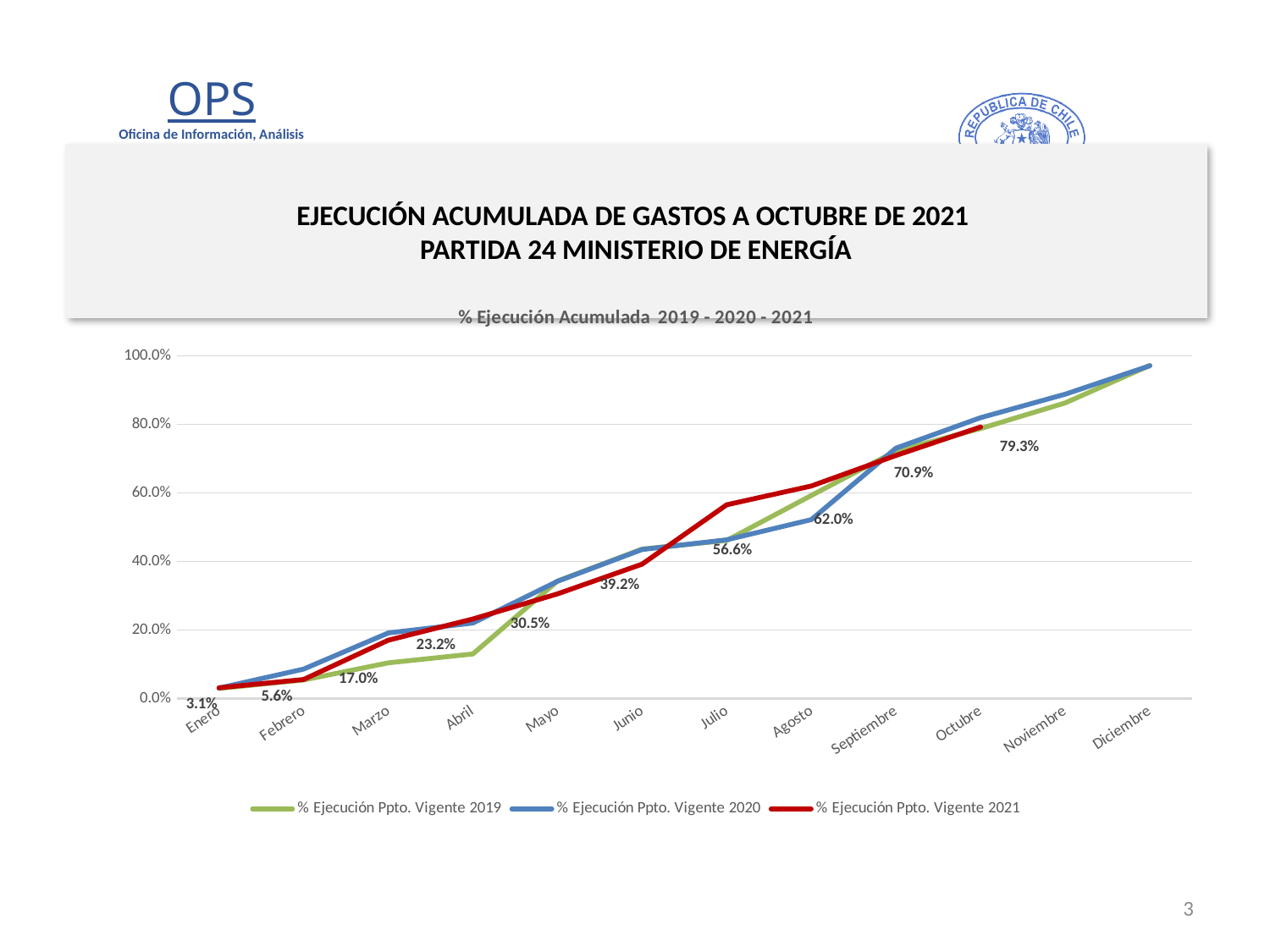
How many months are shown along the x axis? 12 What is the value for % Ejecución Ppto. Vigente 2021 in Enero? 3.1% What is the value for % Ejecución Ppto. Vigente 2021 in Julio? 56.6% How many series does the legend list? 3 Is the value for % Ejecución Ppto. Vigente 2020 in Diciembre greater or less than 80.0%? greater What is the difference between the 2021 values for Julio and Junio? 17.4% What is the title of the chart? % Ejecución Acumulada 2019 - 2020 - 2021 What is the value for % Ejecución Ppto. Vigente 2021 in Octubre? 79.3% What type of chart is shown on the slide? line chart What is the difference between the 2021 values for Octubre and Septiembre? 8.4% What is the value for % Ejecución Ppto. Vigente 2021 in Mayo? 30.5% Does the % Ejecución Ppto. Vigente 2021 series rise or fall from Enero to Octubre? rise